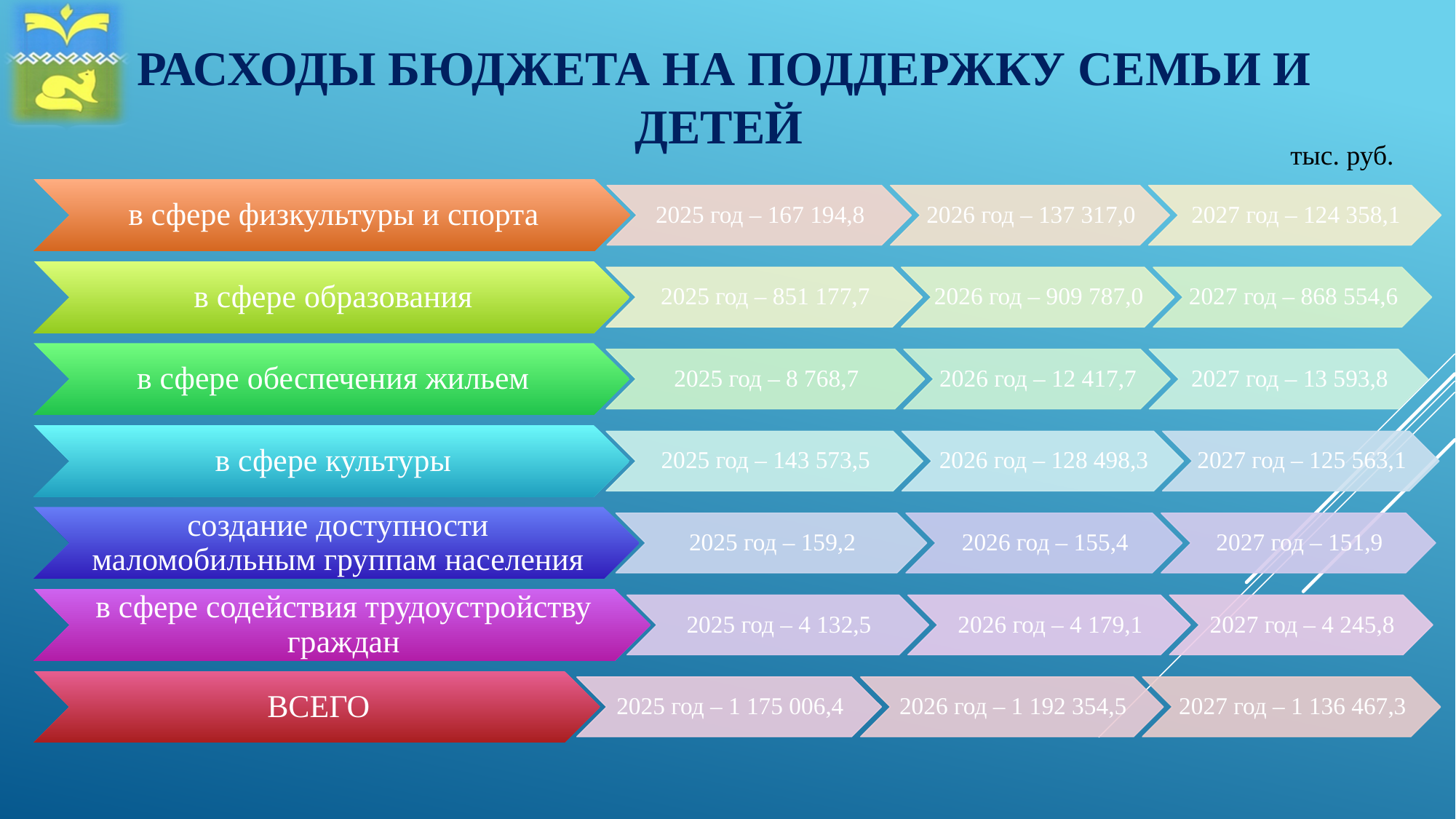
What is the 2025 value for «создание доступности маломобильным группам населения»? 159,2 How many spending areas are listed, not counting the «ВСЕГО» row? 6 In what units are the values on the slide given? тыс. руб. What is the difference between the 2027 and 2025 values for «в сфере обеспечения жильем»? 4 825,1 What is the 2025 value for «в сфере физкультуры и спорта»? 167 194,8 Do the values for «в сфере физкультуры и спорта» rise or fall from 2025 to 2027? fall Which spending area (excluding ВСЕГО) has the highest value in 2025? в сфере образования What is the 2026 value for «в сфере образования»? 909 787,0 By how much does the value for «в сфере образования» in 2026 exceed its value in 2025? 58 609,3 Which spending area (excluding ВСЕГО) has the lowest value in 2027? создание доступности маломобильным группам населения What is the 2027 value for «ВСЕГО»? 1 136 467,3 Which is larger in 2026: «в сфере физкультуры и спорта» or «в сфере культуры»? в сфере физкультуры и спорта